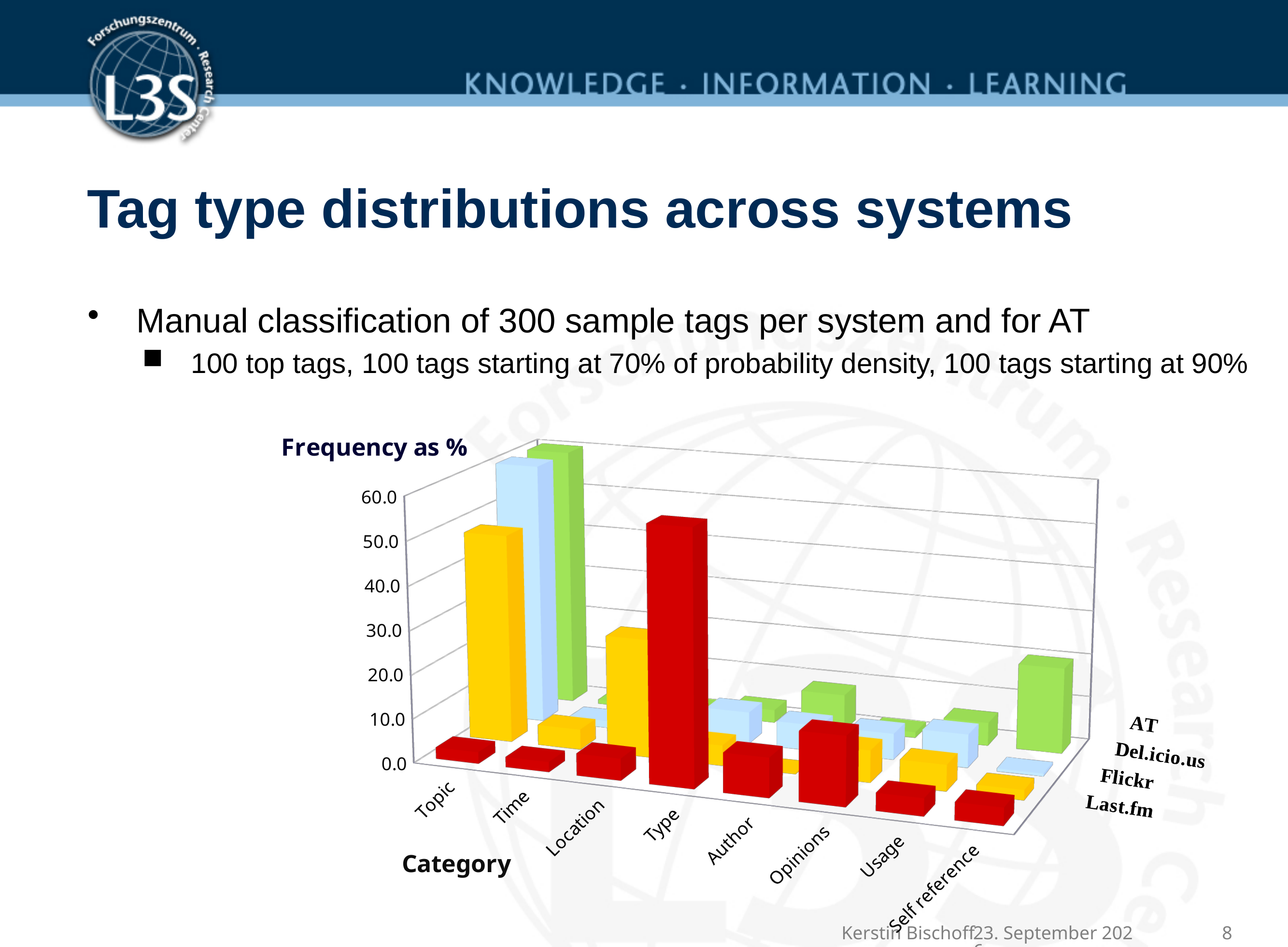
How many categories are shown along the Category axis? 8 For AT, which category has the highest frequency? Topic For Flickr, which is larger: the value for Topic or the value for Location? Topic Is the Last.fm value for Type greater or less than 40.0? greater What kind of chart is shown on the slide? bar chart What is the title of the vertical axis? Frequency as % Is the Last.fm value for Topic greater or less than 10.0? less What is the title of the horizontal category axis? Category For Last.fm, which category has the highest frequency? Type For Flickr, which category has the highest frequency? Topic How many series (systems) does the chart show? 4 Is the Flickr value for Topic greater or less than 40.0? greater